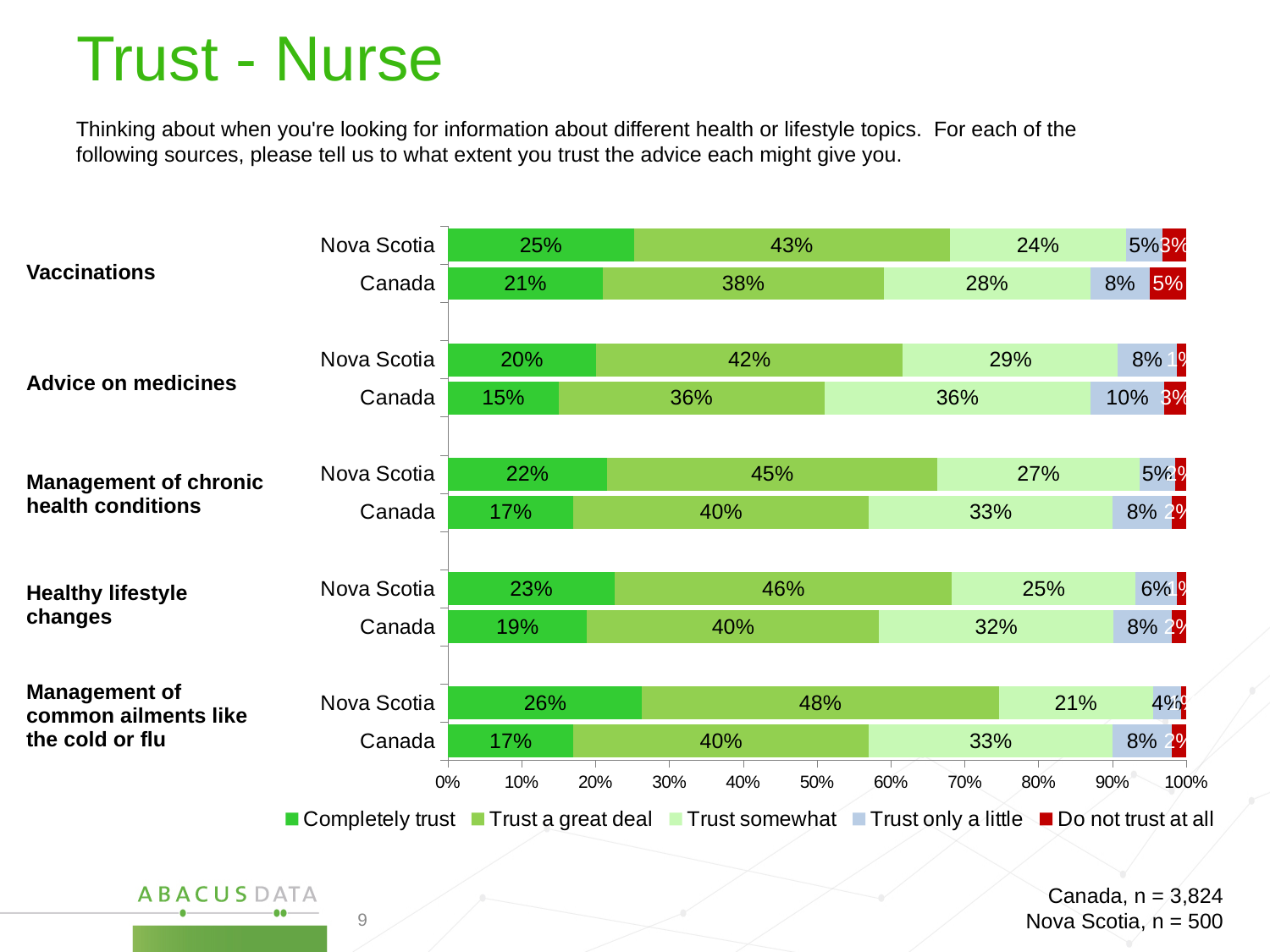
What is the 'Trust only a little' value for Canada on Healthy lifestyle changes? 8% What kind of chart is shown on the slide? stacked bar chart Which is larger: the 'Trust somewhat' value for Canada on Advice on medicines or for Nova Scotia on Advice on medicines? Canada What is the difference between the 'Trust a great deal' values for Nova Scotia and Canada on Management of common ailments like the cold or flu? 8% What is the 'Completely trust' value for Nova Scotia on Vaccinations? 25% Which topic has the lowest 'Completely trust' value for Canada? Advice on medicines Which topic has the highest 'Completely trust' value for Nova Scotia? Management of common ailments like the cold or flu How many bars are plotted on the chart? 10 How many series does the legend list? 5 What is the 'Do not trust at all' value for Canada on Vaccinations? 5% What is the 'Trust a great deal' value for Canada on Advice on medicines? 36% What is the 'Trust somewhat' value for Nova Scotia on Management of chronic health conditions? 27%